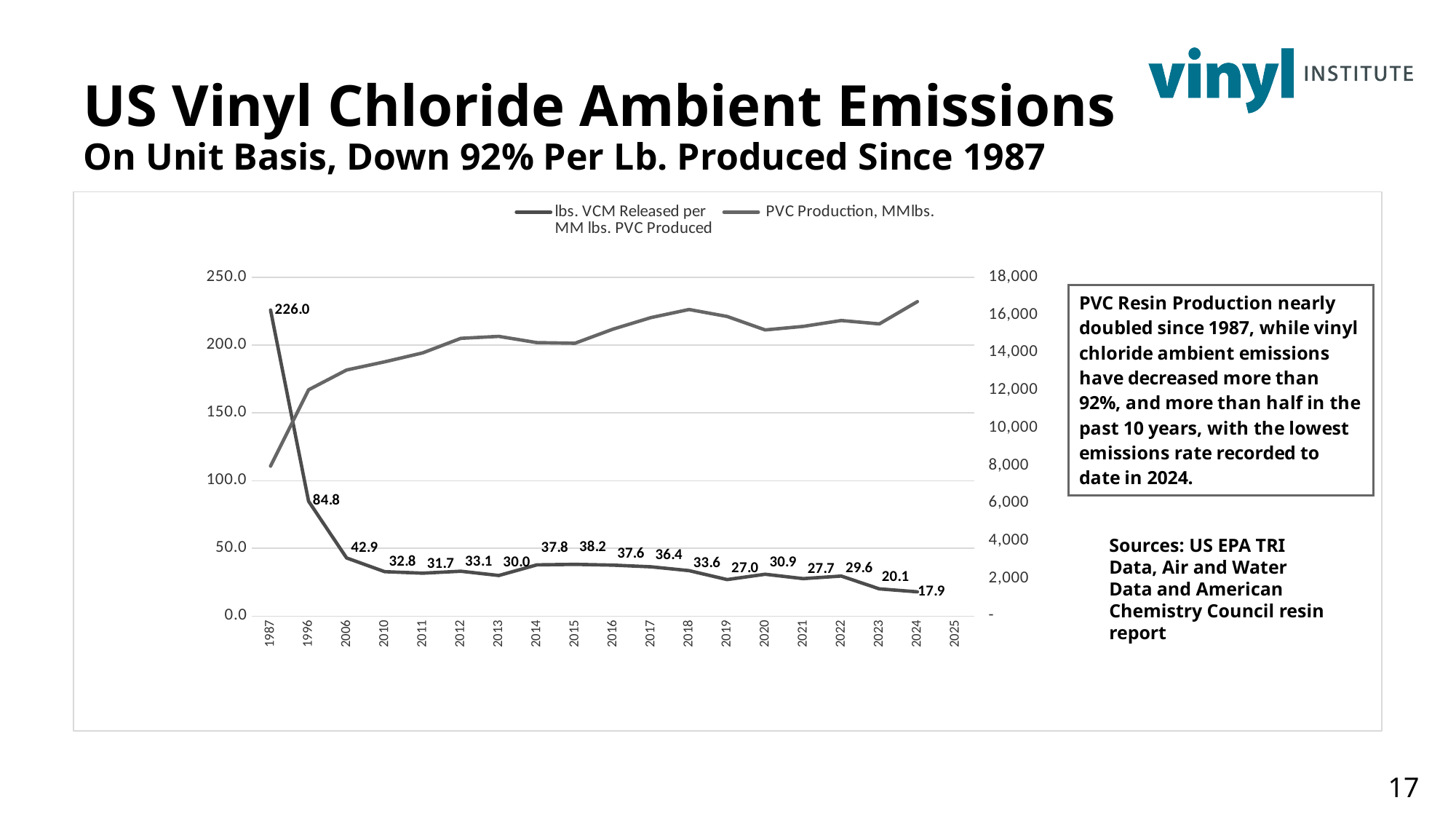
Is the PVC Production, MMlbs. value for 1987 greater or less than 10,000? less What type of chart is shown on the slide? line chart In which year is lbs. VCM Released per MM lbs. PVC Produced highest? 1987 What is the difference between the lbs. VCM Released per MM lbs. PVC Produced values for 1987 and 2024? 208.1 How many years are labeled on the x axis? 19 Which year has the larger lbs. VCM Released per MM lbs. PVC Produced value, 2019 or 2020? 2020 What is the value of lbs. VCM Released per MM lbs. PVC Produced in 1987? 226.0 Does PVC Production, MMlbs. generally rise or fall from 1987 to 2024? rise What is the value of lbs. VCM Released per MM lbs. PVC Produced in 2013? 30.0 In which year is lbs. VCM Released per MM lbs. PVC Produced lowest? 2024 What is the value of lbs. VCM Released per MM lbs. PVC Produced in 2024? 17.9 How many series does the legend list? 2